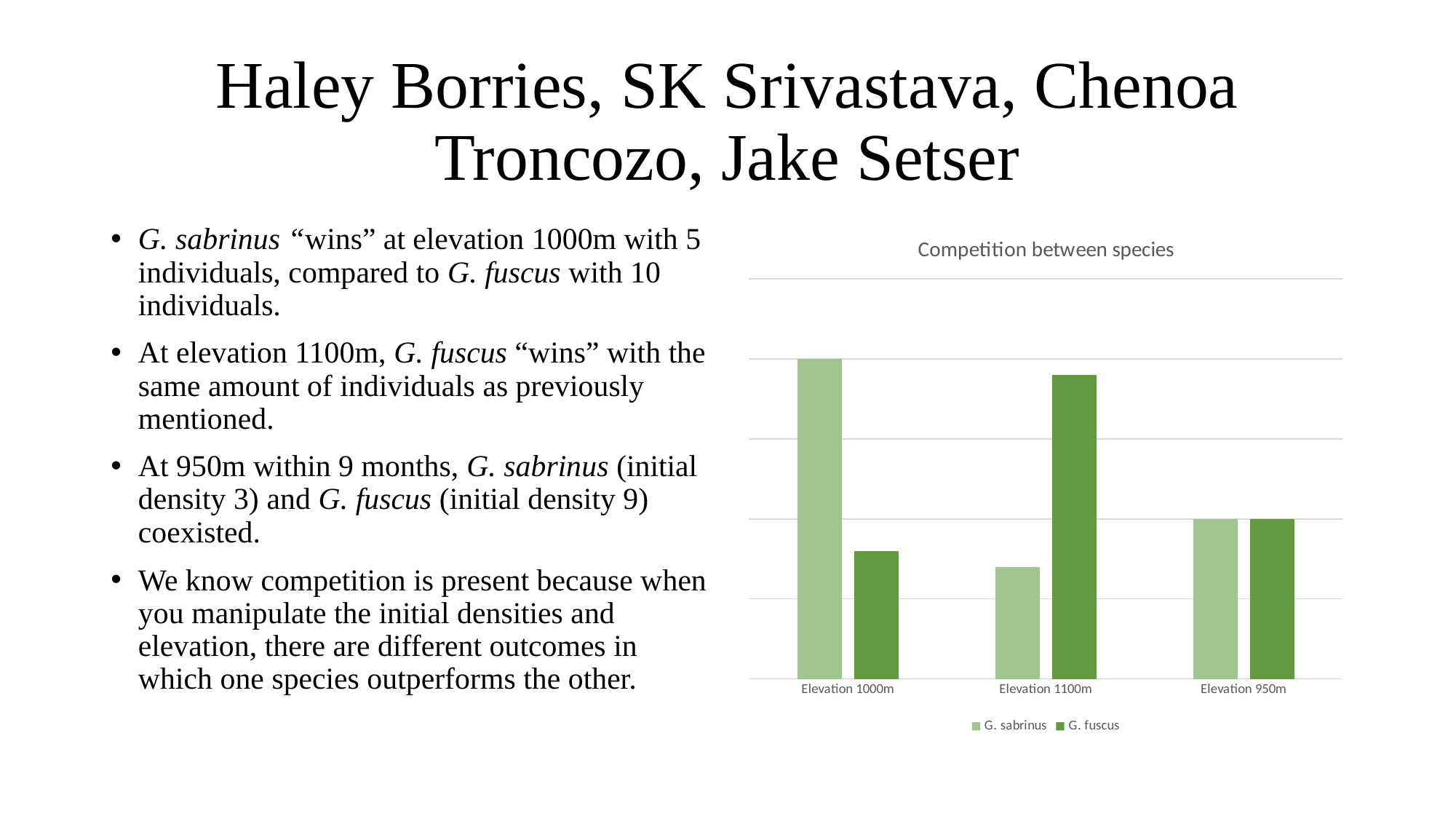
At which elevation is the G. fuscus bar the lowest? Elevation 1000m What kind of chart is shown on the slide? bar chart At which elevation is the G. sabrinus bar the lowest? Elevation 1100m At which elevation is the G. fuscus bar the highest? Elevation 1100m Is the G. fuscus bar at Elevation 950m taller or shorter than the G. fuscus bar at Elevation 1000m? taller What is the title of the chart? Competition between species How many elevation categories are shown on the x axis of the chart? 3 At Elevation 1100m, which species has the taller bar, G. sabrinus or G. fuscus? G. fuscus At Elevation 1000m, which species has the taller bar, G. sabrinus or G. fuscus? G. sabrinus How many series does the chart legend list? 2 Which two series are listed in the chart legend? G. sabrinus and G. fuscus At which elevation is the G. sabrinus bar the highest? Elevation 1000m